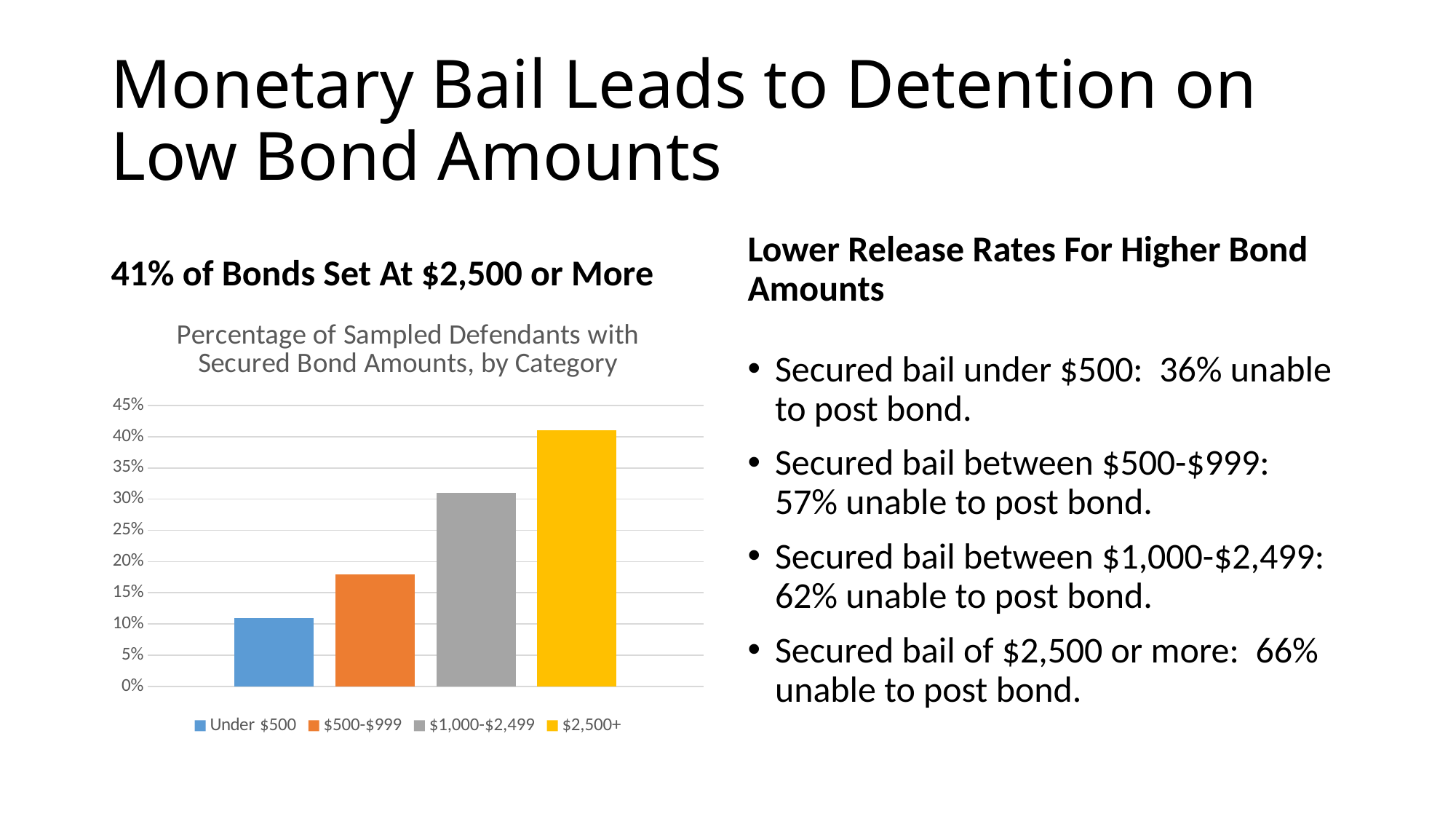
How many bond amount categories are plotted in the chart? 4 Do the bar values rise or fall as the bond amount categories increase from left to right? rise Is the value for $1,000-$2,499 greater or less than 25%? greater What is the title of the chart? Percentage of Sampled Defendants with Secured Bond Amounts, by Category Which is larger, the value for $500-$999 or the value for $1,000-$2,499? $1,000-$2,499 How many entries does the chart legend list? 4 Which bond amount category has the lowest percentage of sampled defendants? Under $500 Is the value for $500-$999 greater or less than 20%? less Which bond amount category has the highest percentage of sampled defendants? $2,500+ Is the value for Under $500 greater or less than 15%? less What percentage of sampled defendants had secured bonds set at $2,500 or more? 41% What kind of chart is shown on the slide? bar chart